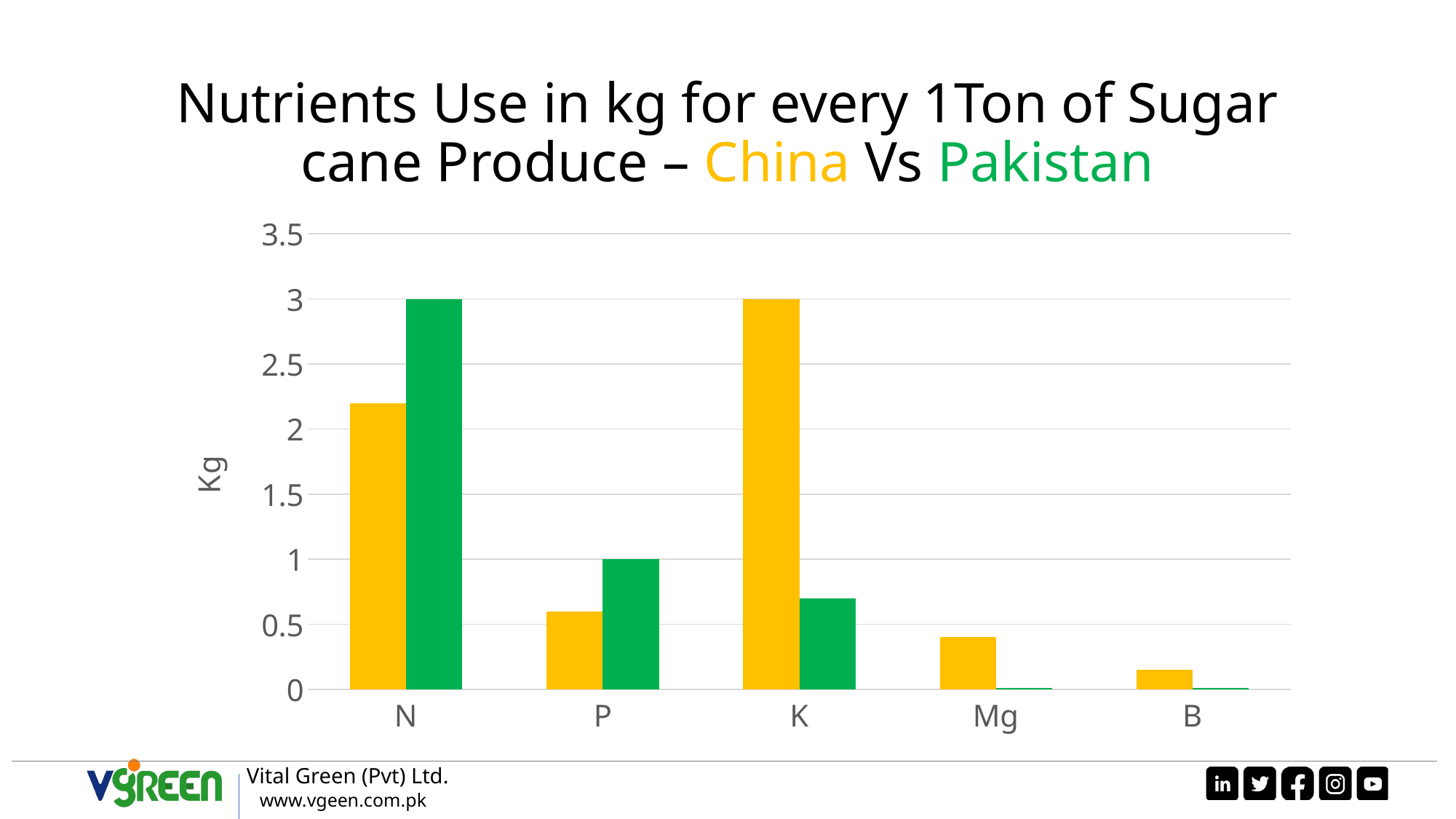
What is the label on the y axis? Kg Is the value for Pakistan for K greater or less than 1? less Which nutrient has the highest value for China? K Is the value for China for N greater or less than 2? greater What is the value for Pakistan for P? 1 What is the value for China for K? 3 Is the value for China for Mg greater or less than 0.5? less What is the value for Pakistan for N? 3 For K, which country has the larger value, China or Pakistan? China What kind of chart is shown on the slide? bar chart For N, which country has the larger value, China or Pakistan? Pakistan How many nutrient categories are shown on the x axis? 5